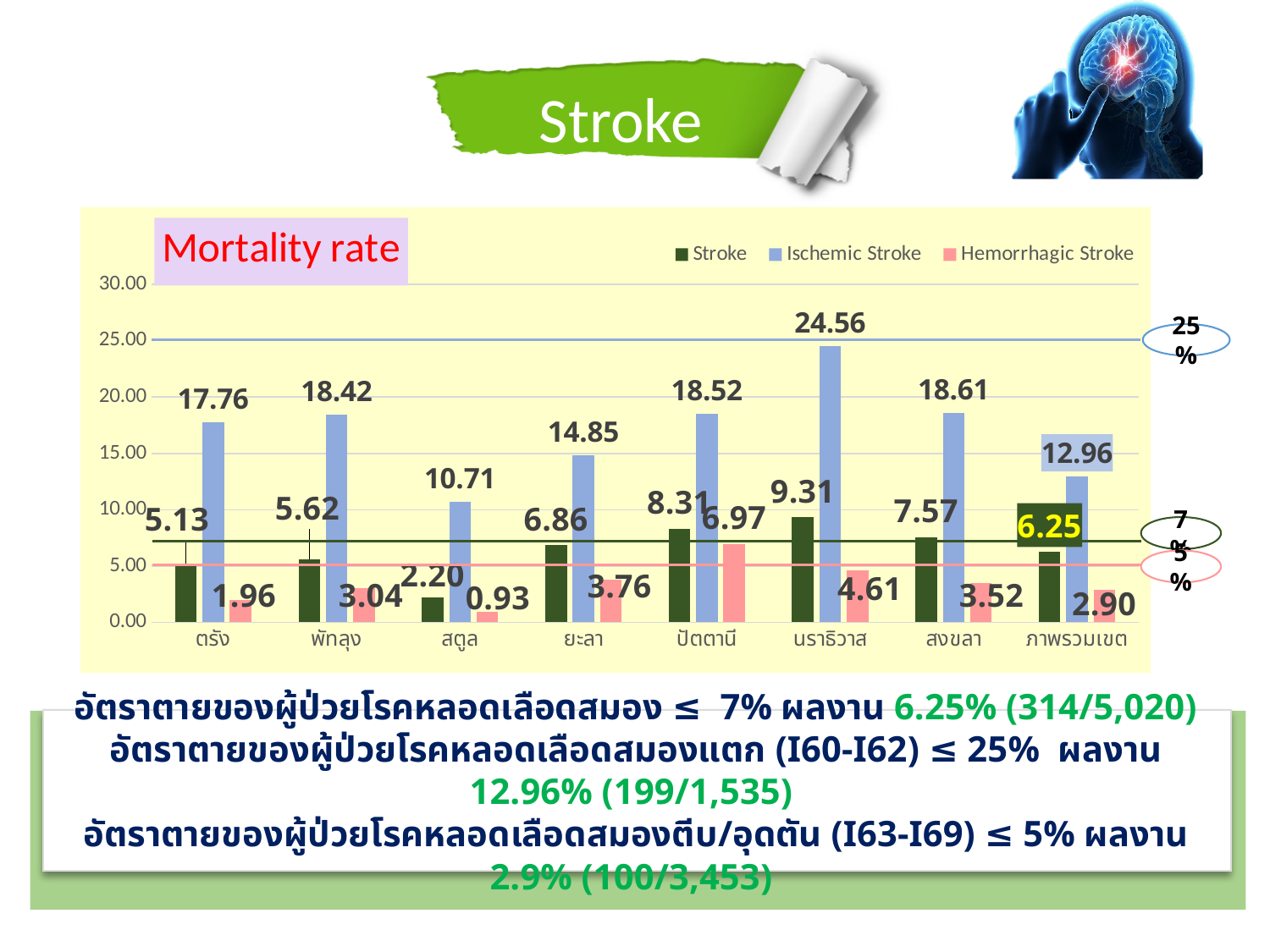
Which is larger, the Stroke value for ปัตตานี or the Stroke value for สงขลา? ปัตตานี How many series does the legend of the Mortality rate chart list? 3 Is the Ischemic Stroke value for ตรัง greater or less than 15.00? greater Which category has the lowest Stroke value? สตูล What is the Ischemic Stroke value for นราธิวาส? 24.56 How many categories are shown on the x axis of the Mortality rate chart? 8 Which category has the highest Ischemic Stroke value? นราธิวาส What type of chart is shown on the slide? bar chart What is the Hemorrhagic Stroke value for สตูล? 0.93 What is the title shown in the box at the top left of the chart? Mortality rate What is the Stroke value for ภาพรวมเขต? 6.25 What is the difference between the Ischemic Stroke values for นราธิวาส and สงขลา? 5.95